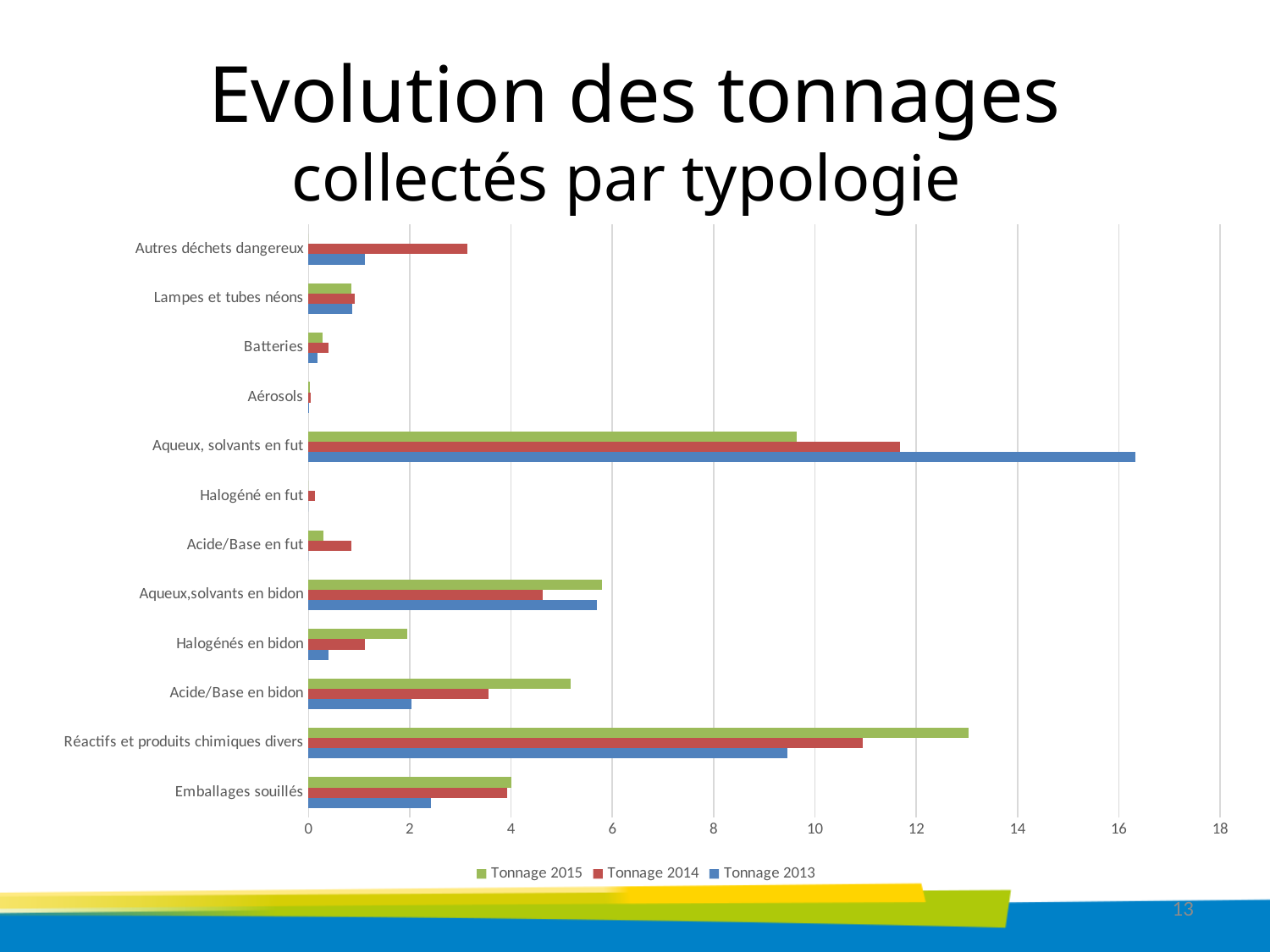
Is the Tonnage 2015 value for Réactifs et produits chimiques divers greater or less than 12? greater Did the tonnage for Aqueux, solvants en fut rise or fall from 2013 to 2015? fall How many series does the legend list? 3 For Aqueux, solvants en fut, which is larger: Tonnage 2013 or Tonnage 2015? Tonnage 2013 Is the Tonnage 2014 value for Acide/Base en bidon greater or less than 4? less What colour represents Tonnage 2013 in the chart? Blue How many categories are shown on the vertical axis of the chart? 12 For Réactifs et produits chimiques divers, which is larger: Tonnage 2015 or Tonnage 2013? Tonnage 2015 Which category has the highest Tonnage 2013 value? Aqueux, solvants en fut What kind of chart is shown on the slide? Bar chart Is the Tonnage 2013 value for Aqueux, solvants en fut greater or less than 14? greater Which category has the highest Tonnage 2015 value? Réactifs et produits chimiques divers